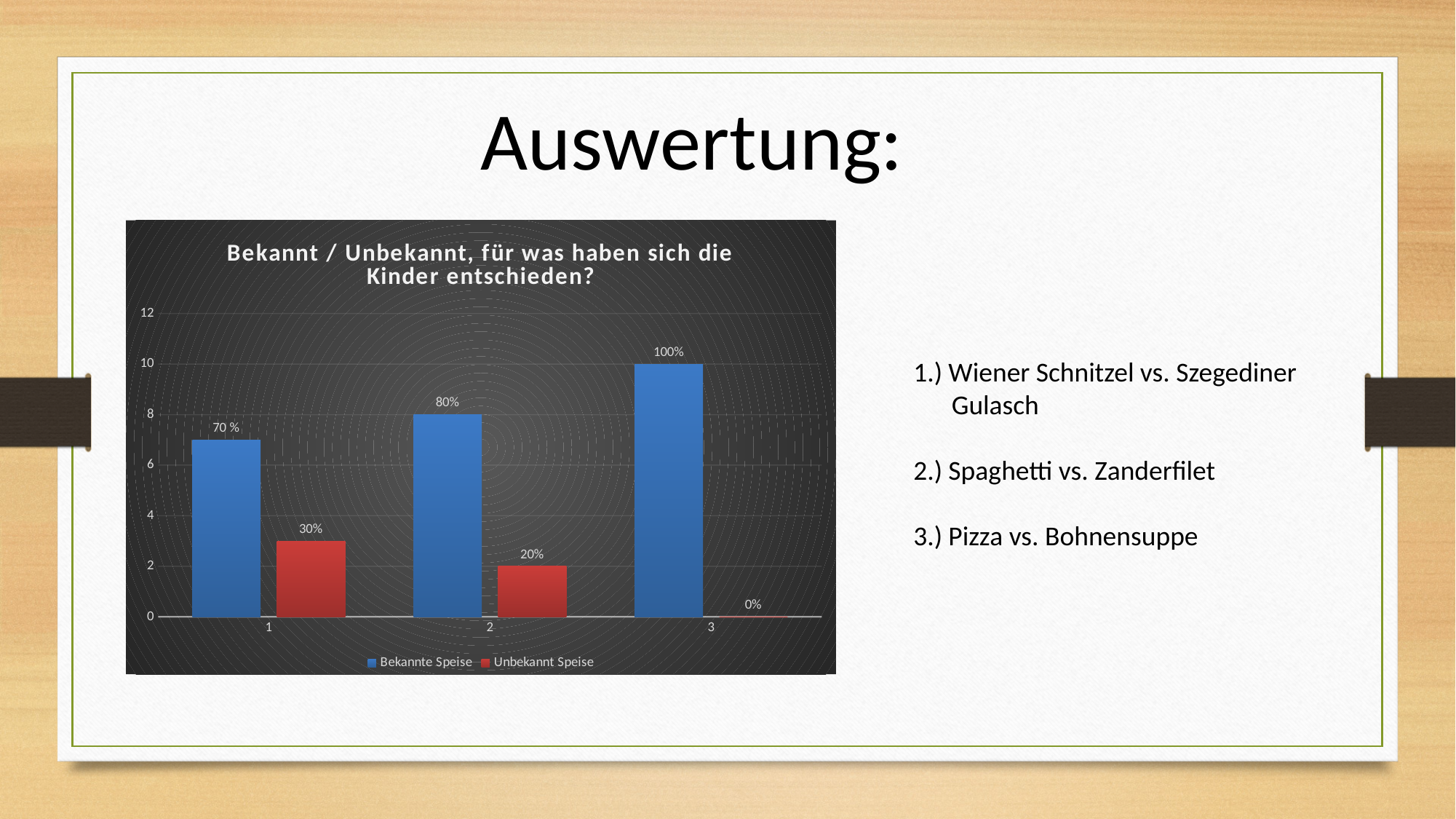
Which category has the lowest Unbekannt Speise bar? 3 What is the data label on the Bekannte Speise bar for category 1? 70 % Is the Bekannte Speise bar for category 2 greater or less than 6 on the y axis? greater Which category has the highest Bekannte Speise bar? 3 What kind of chart is shown on the slide? bar chart How many series does the legend list? 2 How many categories are shown on the x axis? 3 What is the data label on the Bekannte Speise bar for category 3? 100% Do the Bekannte Speise bars rise or fall from category 1 to category 3? rise Which is larger for category 1: the Bekannte Speise bar or the Unbekannt Speise bar? Bekannte Speise What is the data label on the Unbekannt Speise bar for category 3? 0% What is the data label on the Unbekannt Speise bar for category 2? 20%